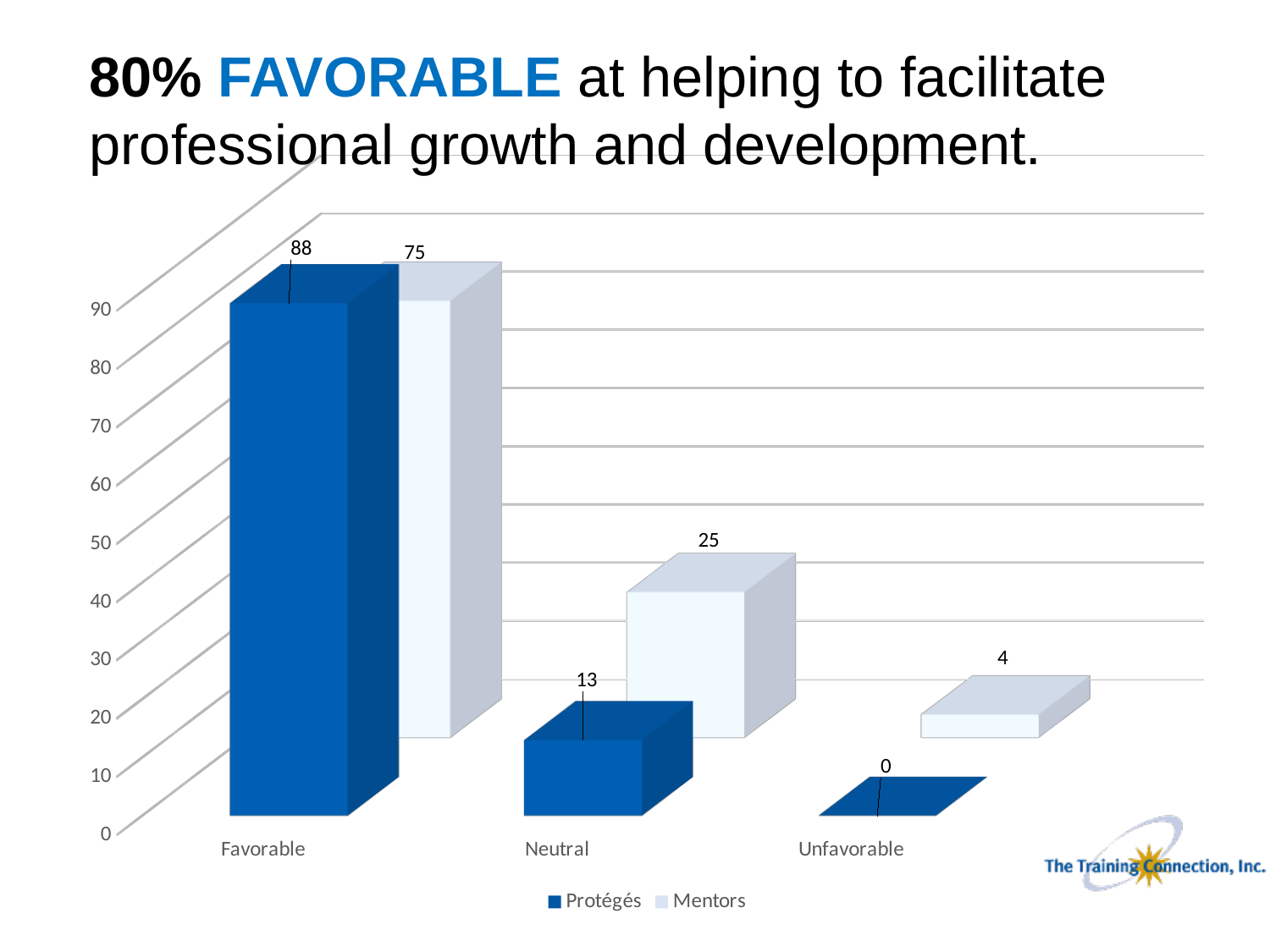
What is the difference between the Protégés and Mentors values in the Favorable category? 13 What is the value for Mentors in the Neutral category? 25 Which category has the highest value for Mentors? Favorable How many categories are shown on the x axis? 3 Do the Protégés values rise or fall from Favorable to Unfavorable? Fall Which category has the lowest value for Protégés? Unfavorable What is the value for Protégés in the Favorable category? 88 How many series does the legend list? 2 In the Neutral category, which series has the larger value, Protégés or Mentors? Mentors What is the value for Mentors in the Unfavorable category? 4 What kind of chart is shown on the slide? Bar chart What is the value for Protégés in the Unfavorable category? 0